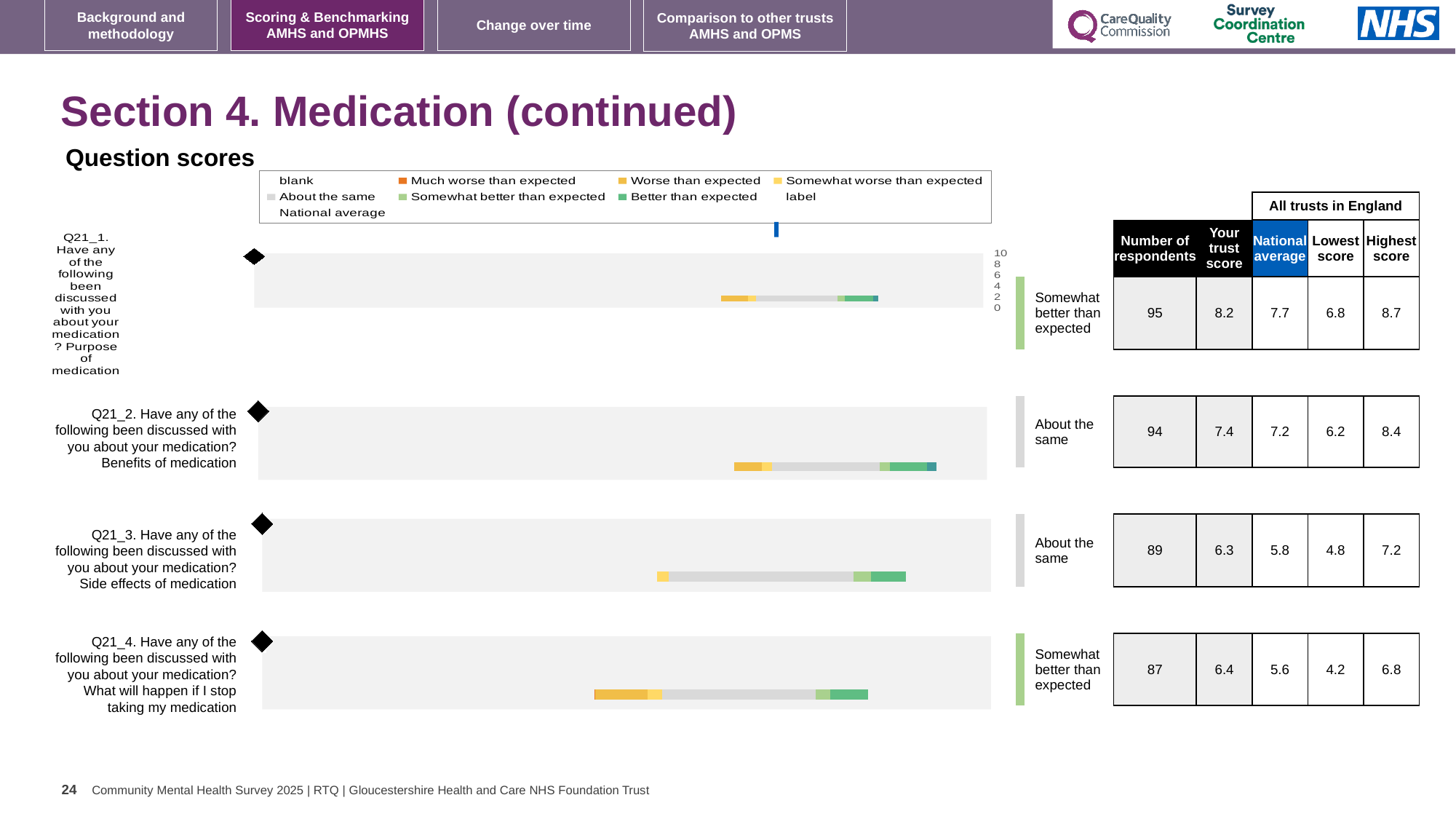
What is the difference between the trust score and the national average for Q21_4? 0.8 What is the highest score across all trusts in England shown for Q21_2 (Benefits of medication)? 8.4 What benchmark category is shown for Q21_1? Somewhat better than expected For Q21_2, which is larger: the trust score or the national average? The trust score How many respondents are shown for Q21_3? 89 How many questions (bars) are shown in the question scores chart? 4 What kind of chart is used to show the question scores on this slide? Bar chart What is the national average shown for Q21_3 (Side effects of medication)? 5.8 What is the trust score shown for Q21_1 (Purpose of medication)? 8.2 Which question has the highest trust score? Q21_1 (Purpose of medication) What is the lowest score across all trusts in England shown for Q21_4 (What will happen if I stop taking my medication)? 4.2 Which question has the lowest trust score? Q21_3 (Side effects of medication)